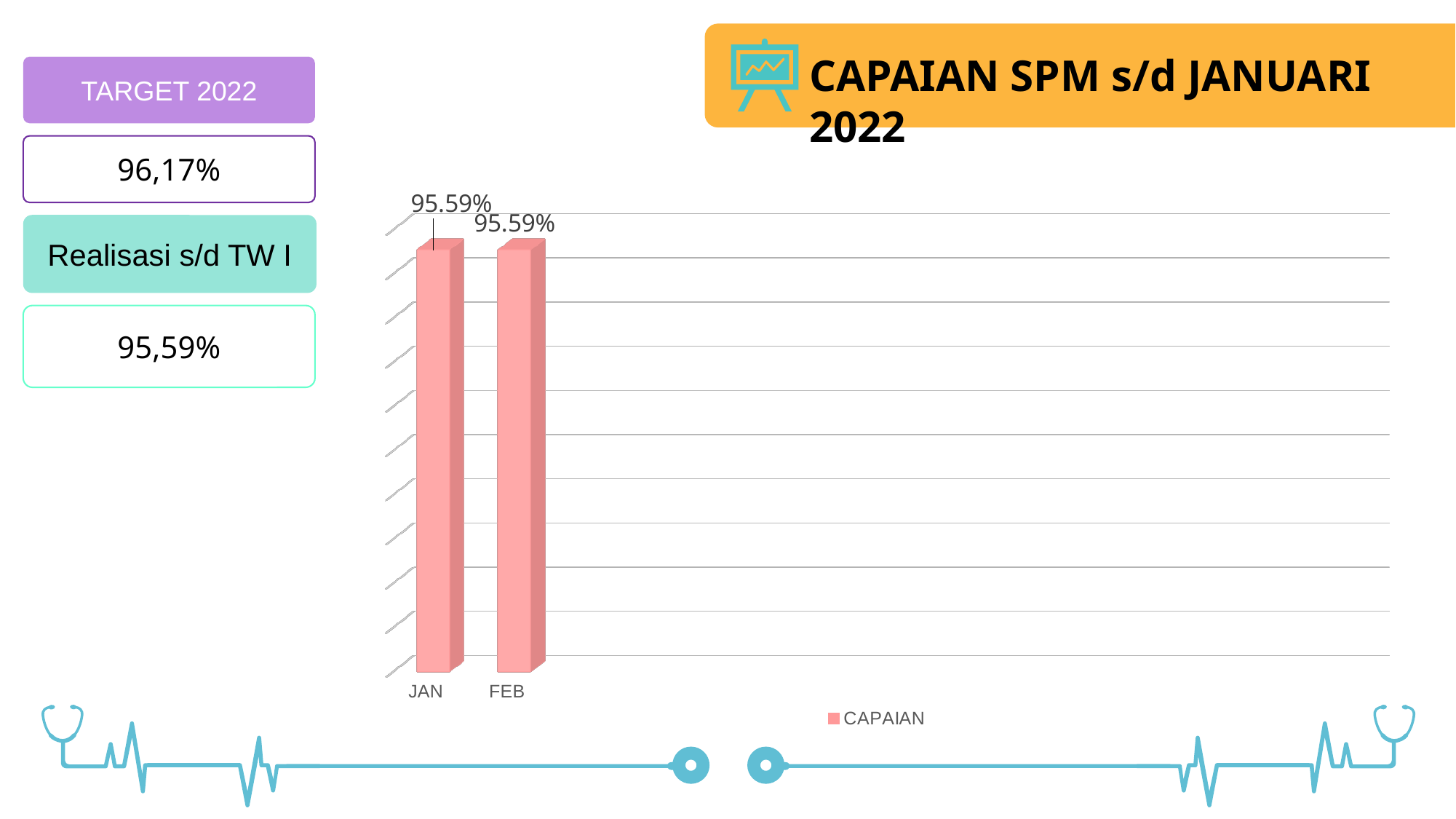
What is the difference between the values for JAN and FEB? 0.00% What is the value for JAN in the chart? 95.59% What kind of chart is shown on the slide? bar chart What is the name of the series shown in the chart legend? CAPAIAN How many categories are plotted on the x axis of the chart? 2 What is the value for FEB in the chart? 95.59% How many series does the chart legend list? 1 What colour are the bars in the chart? pink Which categories are labelled on the x axis of the chart? JAN and FEB Do the values rise, fall, or stay the same from JAN to FEB? stay the same